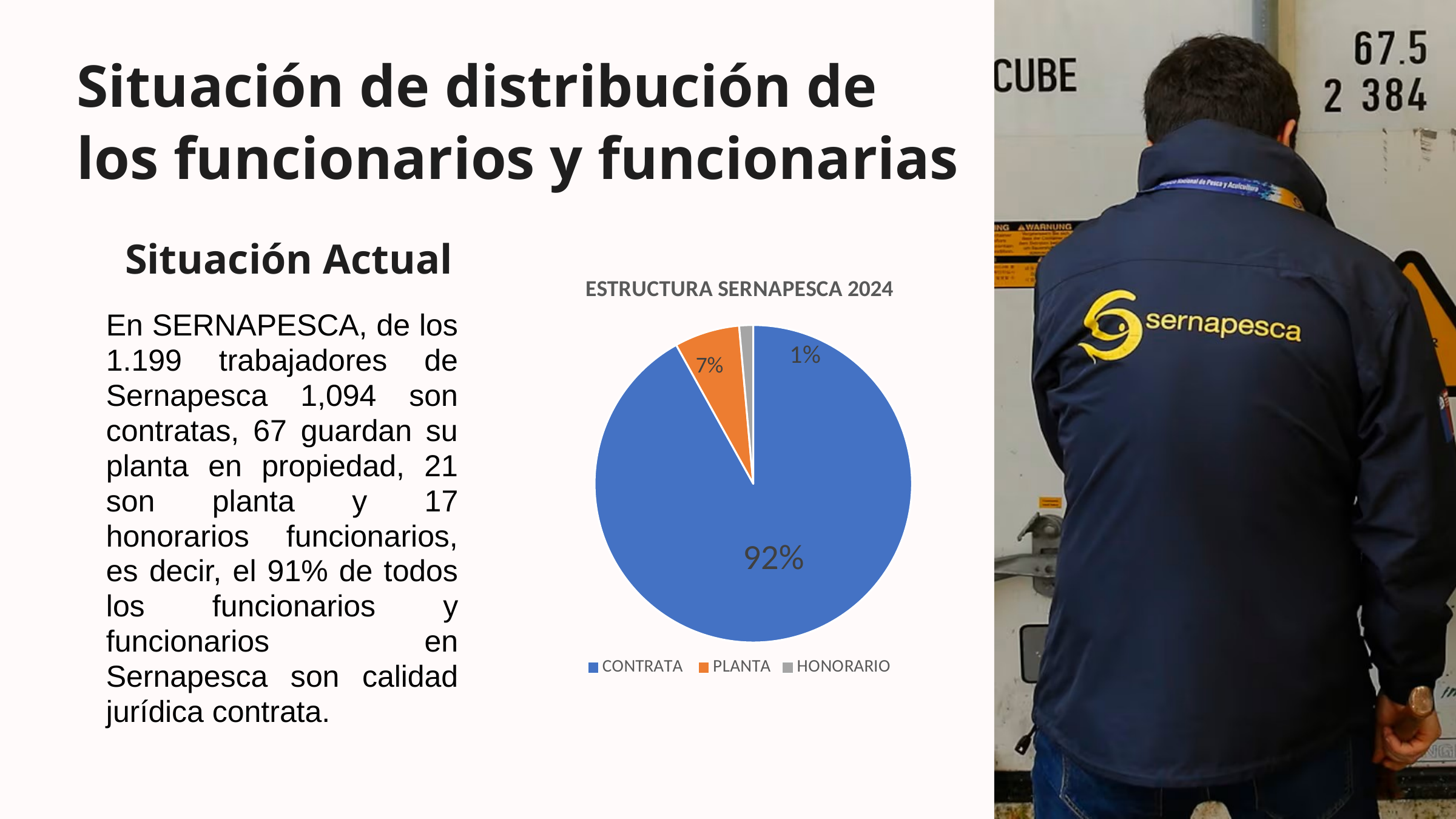
What is the difference in percentage points between the CONTRATA and PLANTA slices? 85 Which category has the largest slice of the pie? CONTRATA What share of the pie does HONORARIO represent? 1% Which is larger, the PLANTA slice or the HONORARIO slice? PLANTA How many entries does the legend list? 3 How many categories does the pie chart show? 3 Which category has the smallest slice of the pie? HONORARIO What share of the pie does CONTRATA represent? 92% What share of the pie does PLANTA represent? 7% What is the title of the chart? ESTRUCTURA SERNAPESCA 2024 What kind of chart is shown on the slide? pie chart What colour is the CONTRATA slice? blue